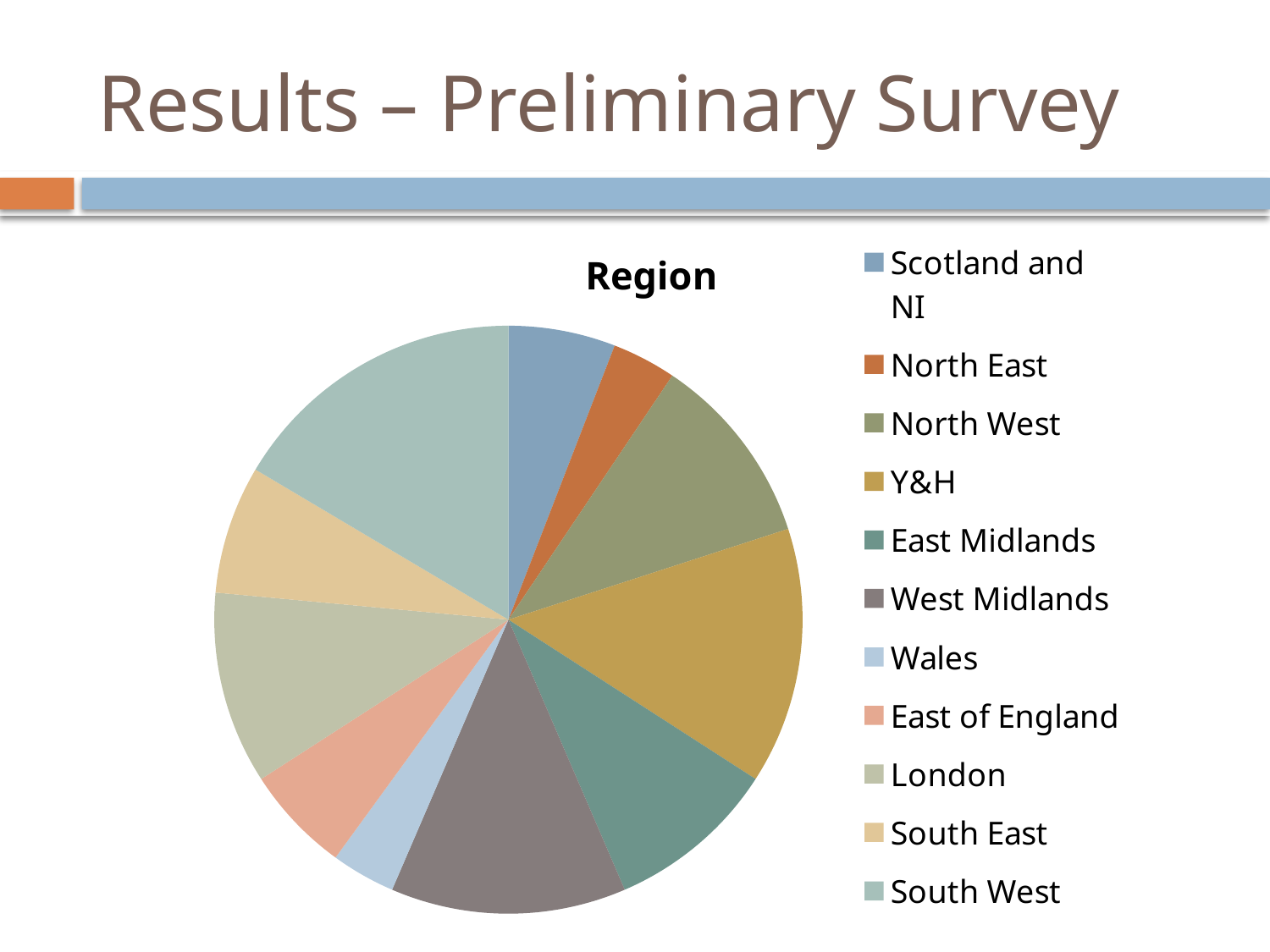
What kind of chart is shown on the slide? Pie chart Which slice is larger, East Midlands or North East? East Midlands Which slice is larger, West Midlands or Scotland and NI? West Midlands Which slice is larger, Y&H or East of England? Y&H Which region is listed first in the chart legend? Scotland and NI How many regions (slices) does the pie chart show? 11 What is the title of the pie chart? Region Which region has the largest slice of the pie chart? South West